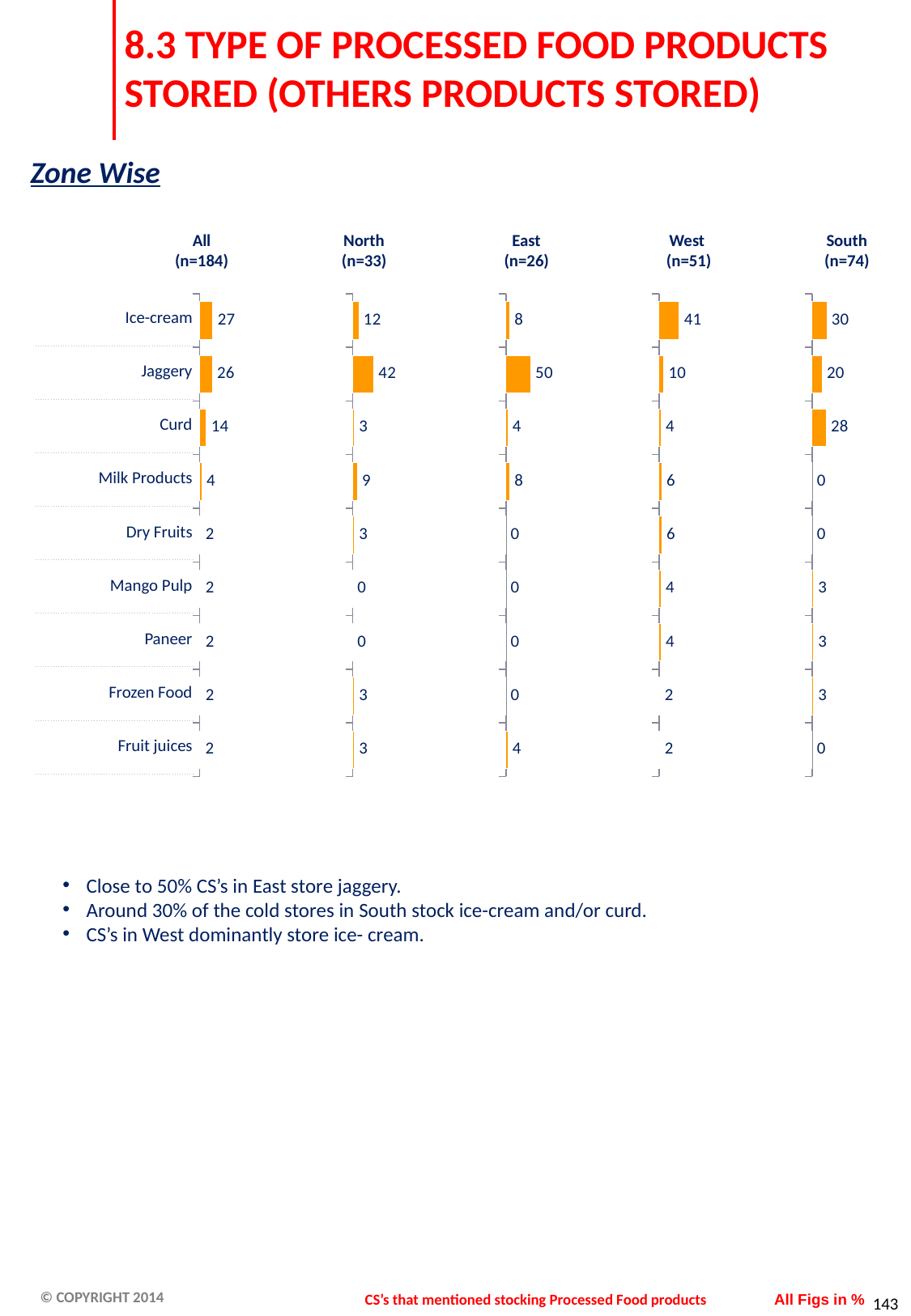
In the East (n=26) chart, what is the value for Jaggery? 50 In the South (n=74) chart, what is the difference between the values for Ice-cream and Jaggery? 10 In the West (n=51) chart, what is the value for Ice-cream? 41 In the South (n=74) chart, what is the value for Curd? 28 In the West (n=51) chart, which is larger, the value for Ice-cream or the value for Jaggery? Ice-cream What kind of chart is used for the All (n=184) data? Bar chart In the North (n=33) chart, what is the difference between the values for Jaggery and Ice-cream? 30 In the East (n=26) chart, which is larger, the value for Milk Products or the value for Curd? Milk Products How many zone charts are shown on the slide, including the All chart? 5 In the All (n=184) chart, which category has the highest value? Ice-cream In the North (n=33) chart, which category has the highest value? Jaggery How many categories are shown in the All (n=184) chart? 9